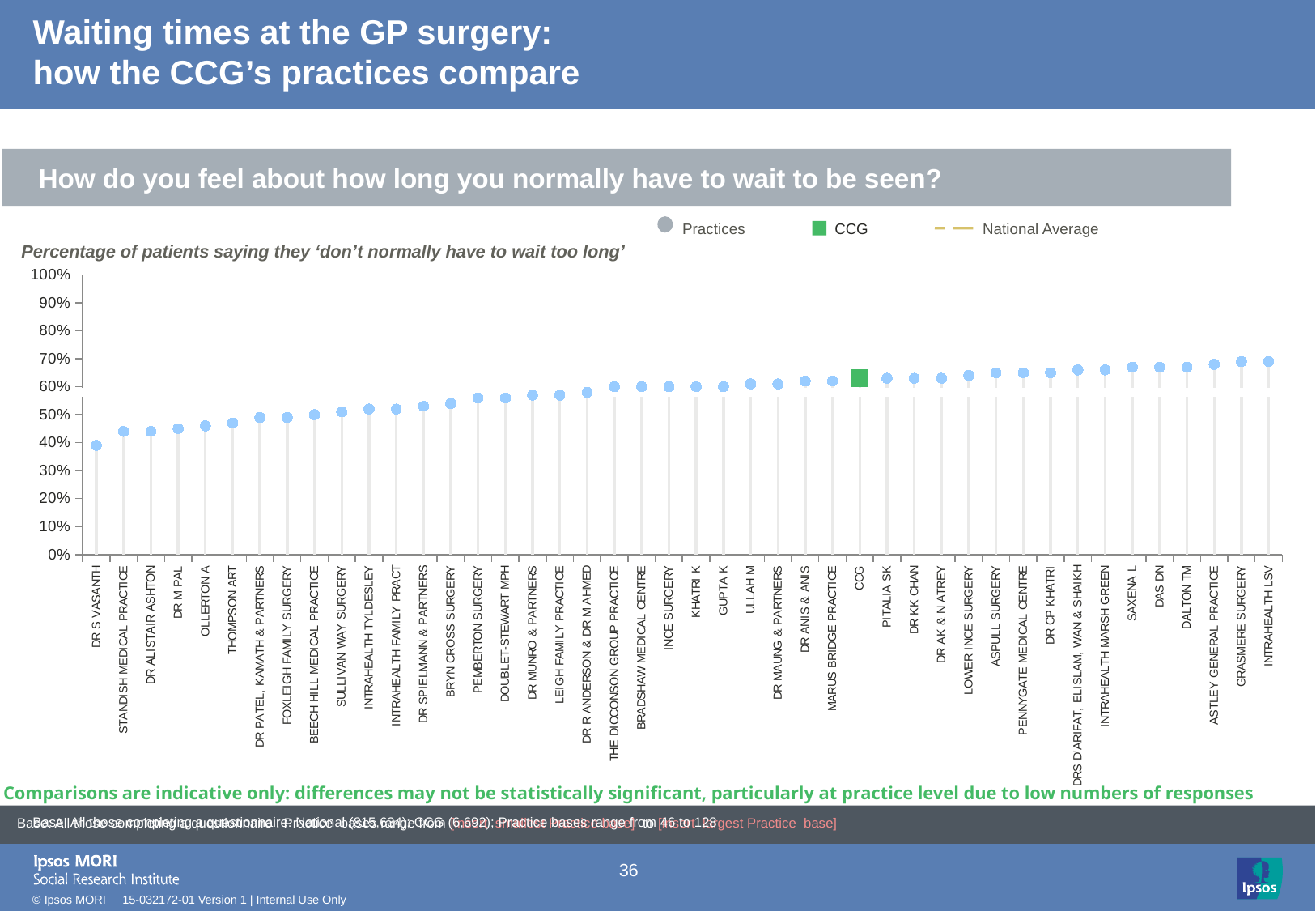
What is the highest value shown on the y axis? 100% Is the value for INTRAHEALTH LSV greater or less than 60%? greater Which practice has the lowest percentage of patients saying they 'don't normally have to wait too long'? DR S VASANTH Is the value for DR S VASANTH greater or less than 50%? less Which has the higher value, DR M PAL or DALTON TM? DALTON TM Is the value for GRASMERE SURGERY greater or less than 60%? greater Do the values rise or fall moving from left to right along the x axis? rise What colour is the CCG marker in the chart? green How many series does the legend list? 3 Which has the higher value, DR S VASANTH or INTRAHEALTH LSV? INTRAHEALTH LSV